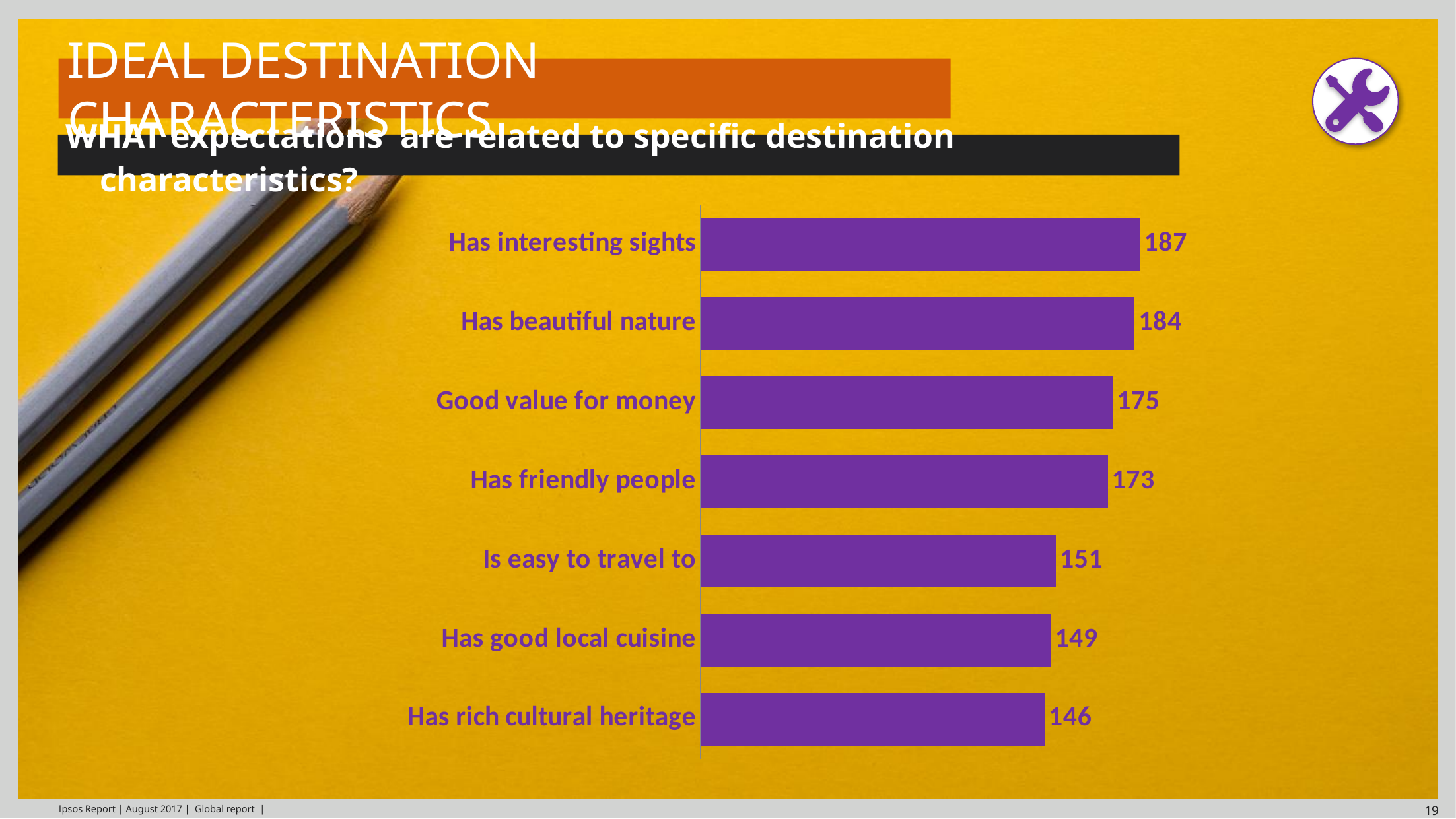
What is the value for Good value for money? 175 What is the difference between the values for Has beautiful nature and Has friendly people? 11 What is the value for Is easy to travel to? 151 Which category has the highest value? Has interesting sights What is the value for Has interesting sights? 187 What is the difference between the values for Has interesting sights and Has rich cultural heritage? 41 Which has a larger value, Good value for money or Is easy to travel to? Good value for money What colour are the bars in the chart? Purple Which category has the lowest value? Has rich cultural heritage What kind of chart is shown on the slide? Bar chart What is the value for Has good local cuisine? 149 How many categories are shown in the chart? 7